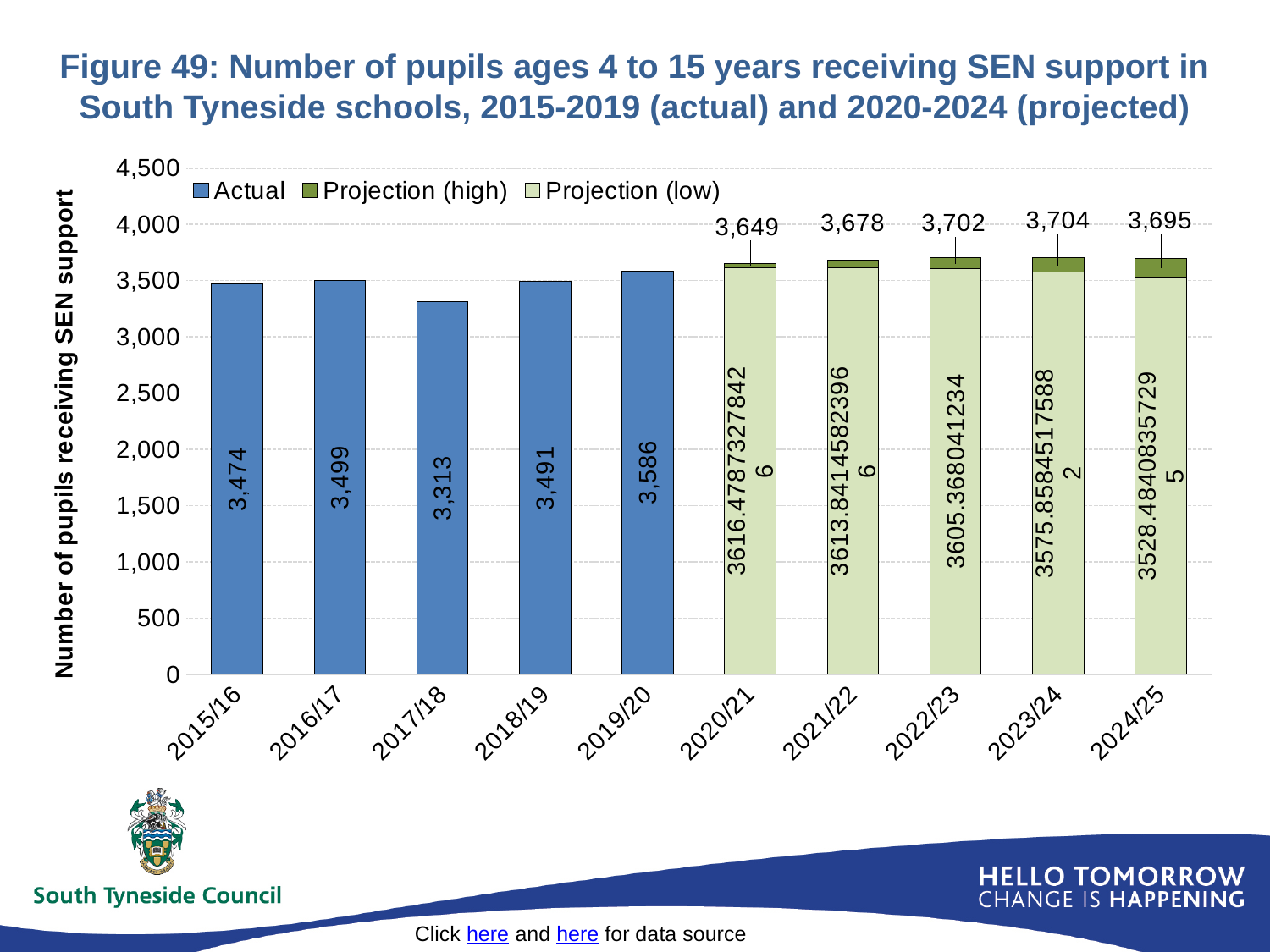
What is the difference between the Projection (high) values for 2024/25 and 2020/21? 46 What is the difference between the actual values for 2019/20 and 2015/16? 112 Is the actual value for 2017/18 greater or less than 3,500? less What is the actual number of pupils receiving SEN support in 2019/20? 3,586 Which year has the highest Projection (high) value? 2023/24 What is the Projection (high) value for 2022/23? 3,702 How many years are shown on the x axis? 10 Which year has the highest actual (non-projected) number of pupils receiving SEN support? 2019/20 How many series does the legend list? 3 Which is larger, the actual value for 2016/17 or for 2017/18? 2016/17 Which year has the lowest actual number of pupils receiving SEN support? 2017/18 What is the number of pupils receiving SEN support in 2015/16? 3,474